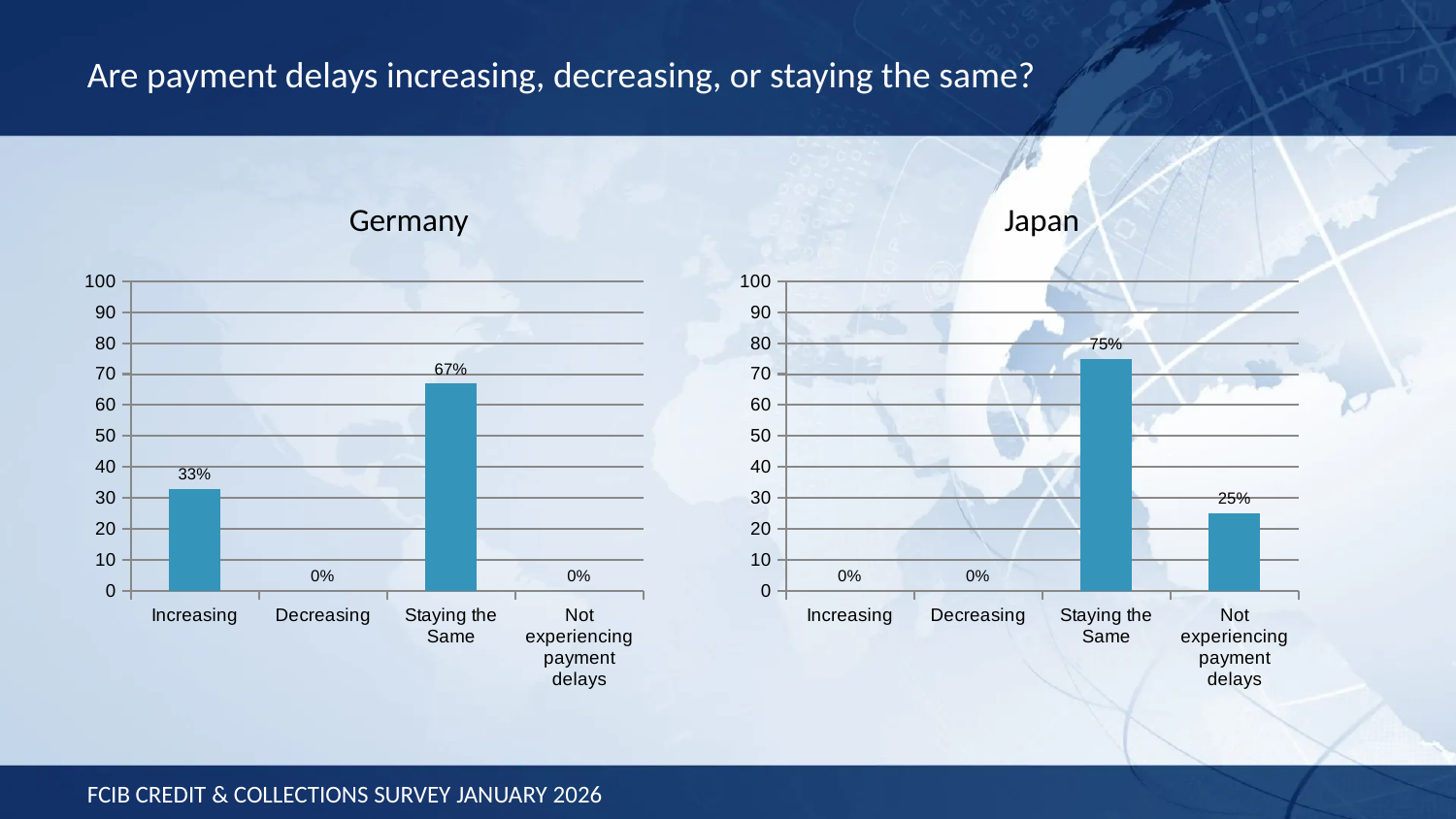
In the Japan chart, what is the value for Increasing? 0% What type of chart is the Japan chart? Bar chart In the Japan chart, which category has the highest value? Staying the Same How many categories are shown in the Germany chart? 4 In the Germany chart, what is the value for Increasing? 33% In the Japan chart, what is the value for Not experiencing payment delays? 25% In the Germany chart, what is the value for Staying the Same? 67% In the Japan chart, what is the difference between Staying the Same and Not experiencing payment delays? 50% Which is larger: Staying the Same in the Germany chart or Staying the Same in the Japan chart? Japan In the Japan chart, what is the value for Staying the Same? 75% In the Germany chart, which category has the highest value? Staying the Same In the Germany chart, what is the difference between Staying the Same and Increasing? 34%